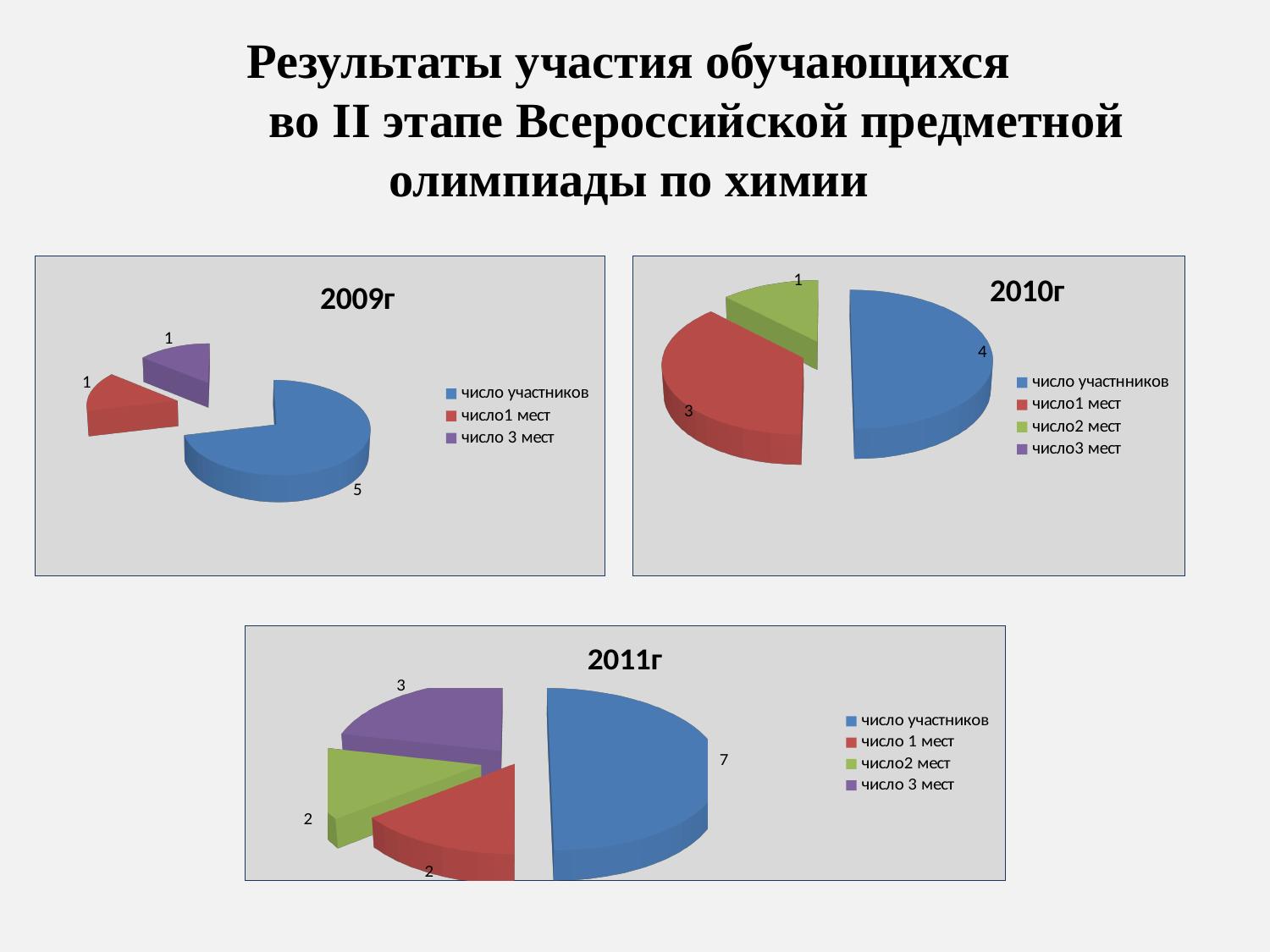
In the 2011г chart, what share of the total do the число участников slice represent? 50% How many entries does the legend of the 2009г chart list? 3 In the 2011г chart, what is the difference between число участников and число 3 мест? 4 In the 2010г chart, what is the difference between число участнников and число2 мест? 3 In the 2011г chart, what is the value for число 3 мест? 3 In the 2011г chart, which category has the smallest value among the labelled slices, число 1 мест or число 3 мест? число 1 мест How many entries does the legend of the 2010г chart list? 4 In the 2010г chart, which category has the largest slice? число участнников In the 2011г chart, what is the value for число участников? 7 In the 2010г chart, what is the value for число1 мест? 3 What kind of chart is the 2009г chart? pie chart In the 2009г chart, what is the value for число участников? 5